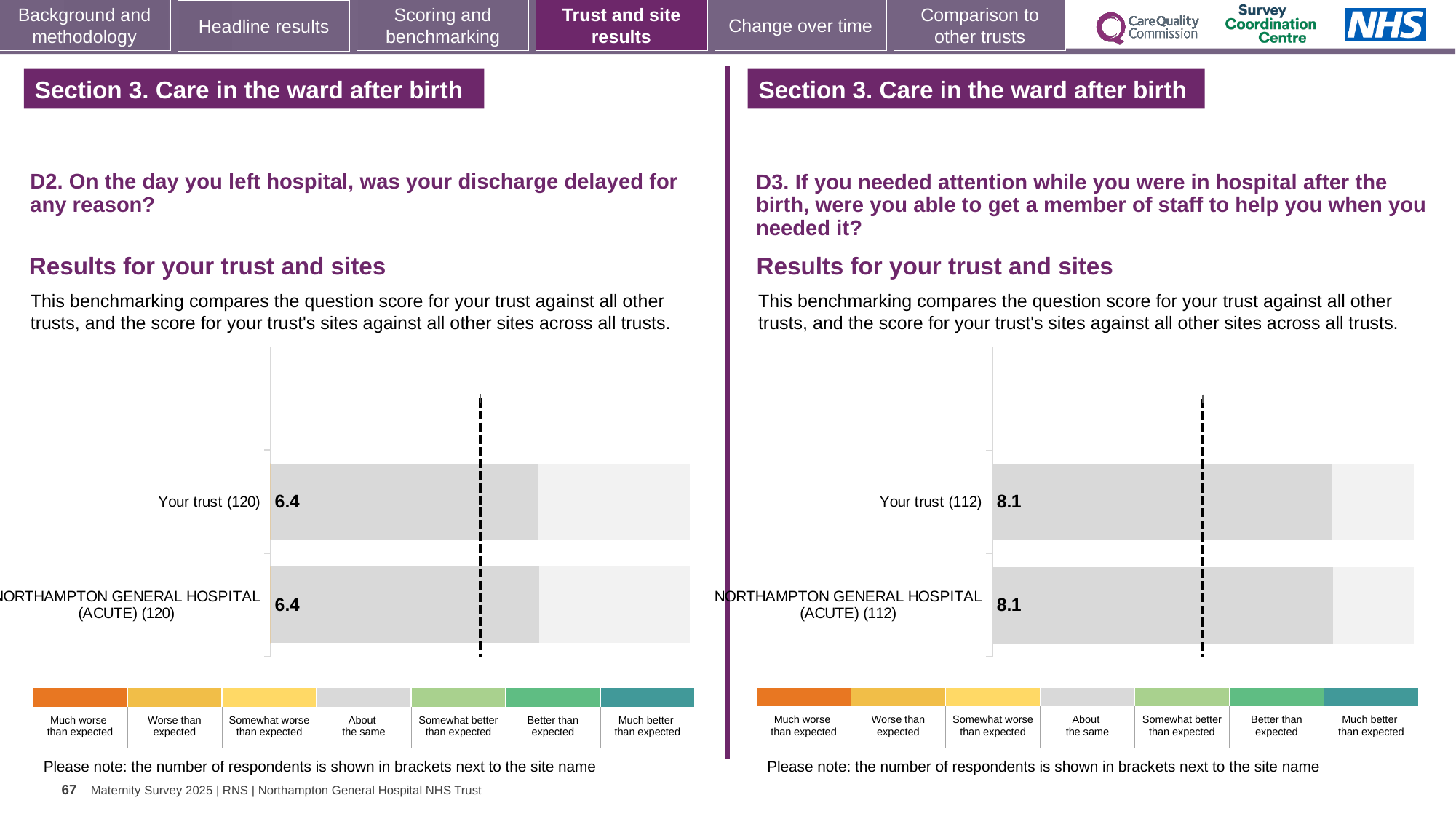
In the left chart (D2), what is the difference between the score for Your trust and the score for Northampton General Hospital (Acute)? 0 How many bars are plotted in the right chart (D3)? 2 In the left chart (D2, discharge delayed), what is the score for Your trust (120)? 6.4 Is the score for Your trust in the right chart (D3) larger or smaller than the score for Your trust in the left chart (D2)? Larger How many respondents are shown in brackets for Your trust in the left chart (D2)? 120 In the right chart (D3), what is the difference between the score for Your trust and the score for Northampton General Hospital (Acute)? 0 How many bars are plotted in the left chart (D2)? 2 What kind of chart is used for the D2 results on the left? Bar chart How many respondents are shown in brackets for Your trust in the right chart (D3)? 112 In the left chart (D2, discharge delayed), what is the score for Northampton General Hospital (Acute) (120)? 6.4 In the right chart (D3, able to get a member of staff to help), what is the score for Northampton General Hospital (Acute) (112)? 8.1 In the right chart (D3, able to get a member of staff to help), what is the score for Your trust (112)? 8.1